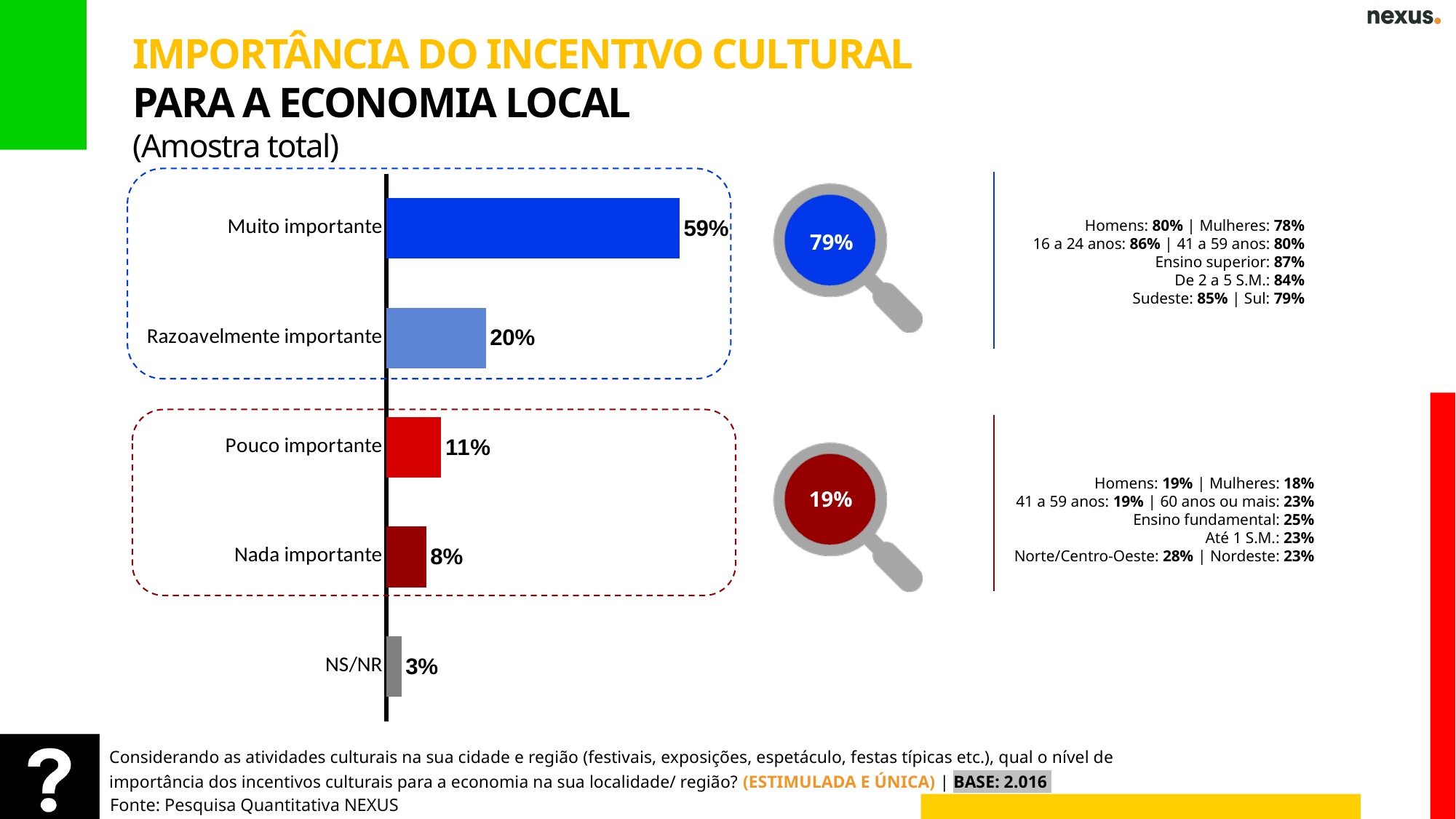
What is the value for "Muito importante"? 59% What is the difference between the values for "Muito importante" and "Razoavelmente importante"? 39% Which category has the lowest value? NS/NR What is the value for "NS/NR"? 3% What is the value for "Razoavelmente importante"? 20% How many categories are shown in the bar chart? 5 Which is larger, the value for "Pouco importante" or "Nada importante"? Pouco importante Which category has the highest value? Muito importante What is the combined total of "Muito importante" and "Razoavelmente importante" shown in the blue circle? 79% What is the value for "Pouco importante"? 11% What kind of chart is shown on the slide? Bar chart What is the value for "Nada importante"? 8%